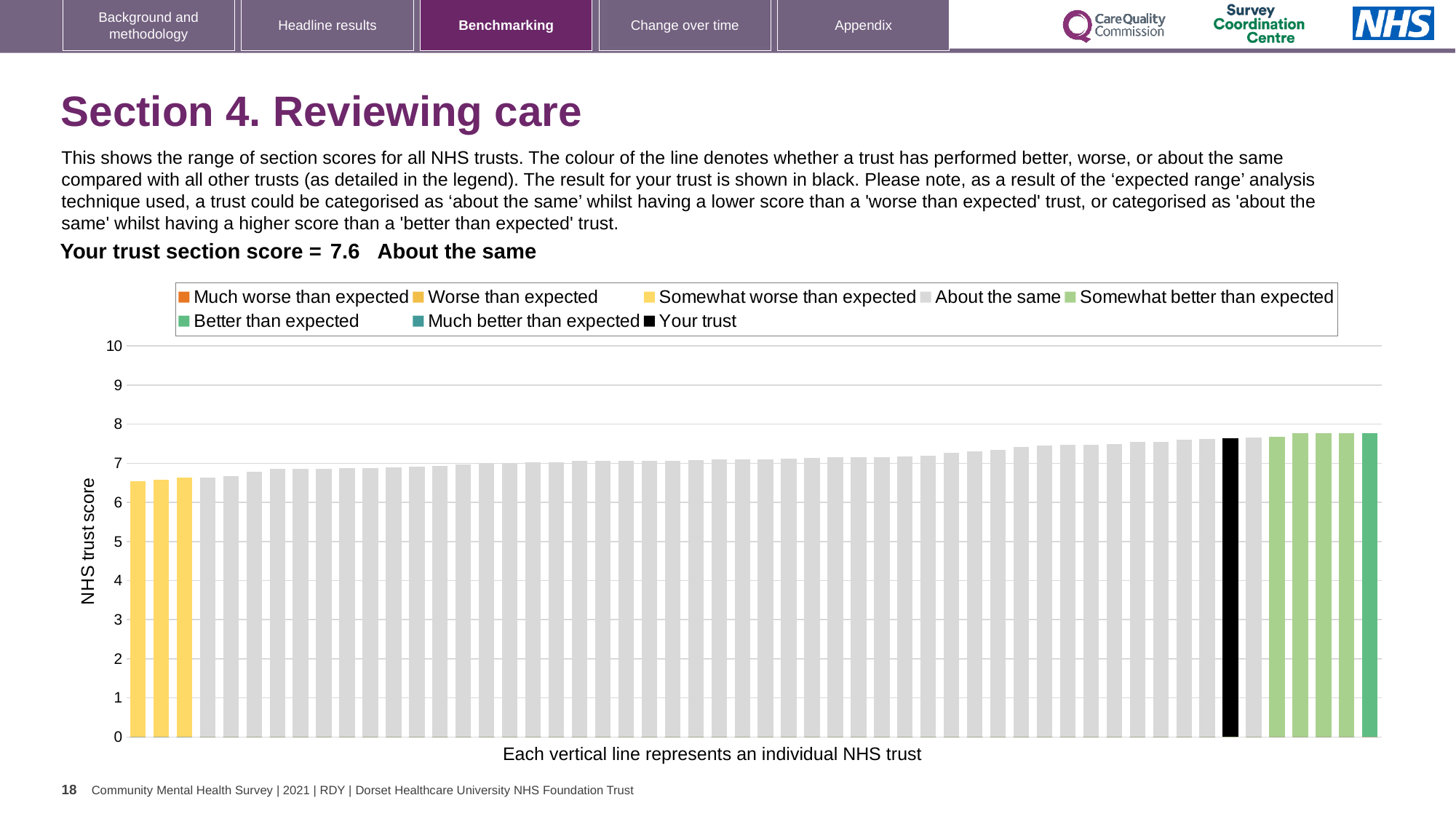
What is the section score for your trust shown on the slide? 7.6 How many entries does the chart legend list? 8 Is the value for your trust's bar greater or less than 7? greater What colour is the bar representing your trust? black Is the value of the highest bar in the chart greater or less than 8? less What kind of chart is shown on the slide? bar chart What is the label on the vertical axis of the chart? NHS trust score How many bars are coloured light green (Somewhat better than expected)? 4 Which performance category is your trust placed in for this section? About the same Do the bar values rise or fall from left to right across the chart? rise How many bars are coloured yellow (Somewhat worse than expected)? 3 Is the value of the lowest bar in the chart greater or less than 7? less